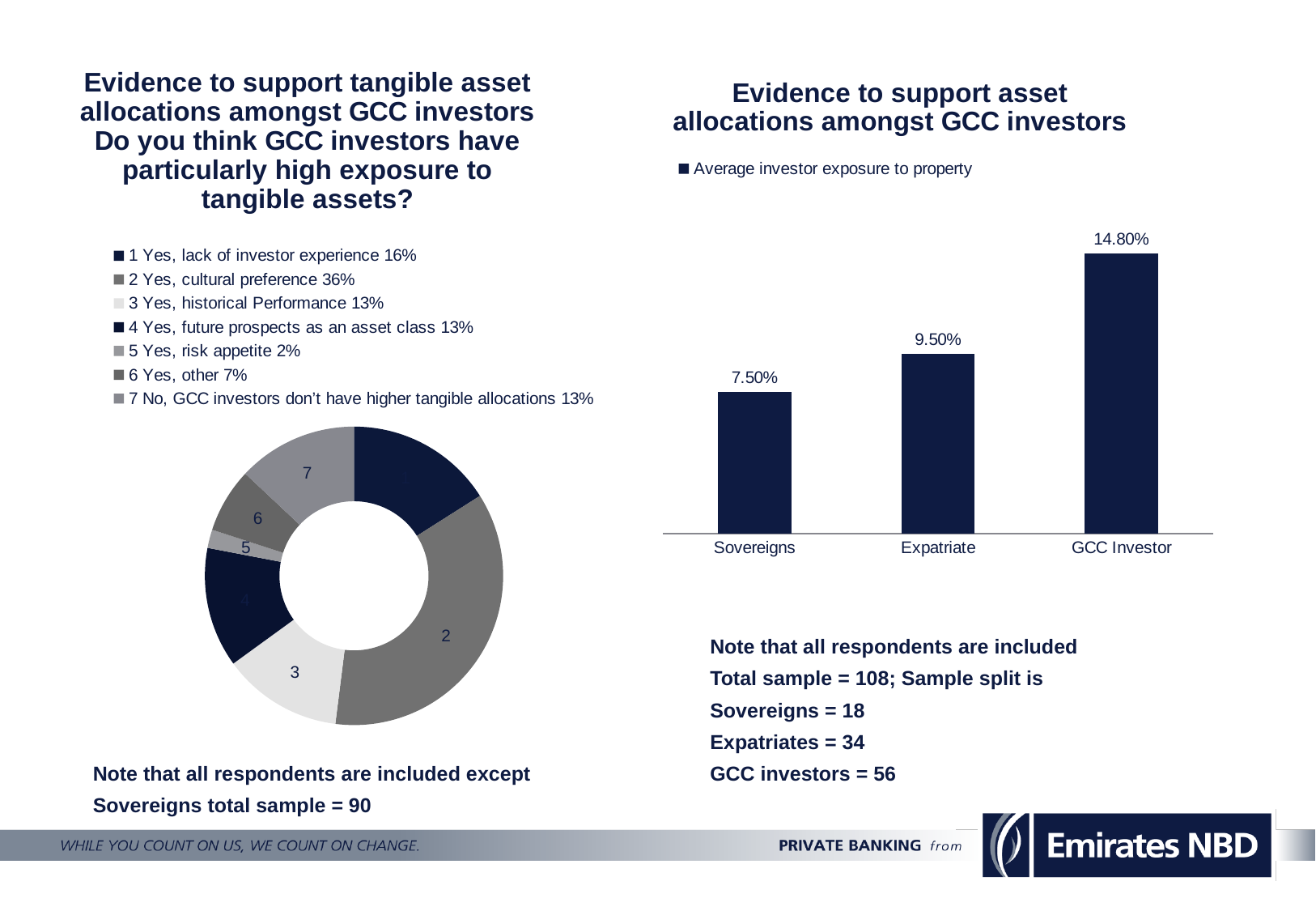
In the bar chart on the right, what is the difference between the GCC Investor value and the Expatriate value? 5.30% In the donut chart on the left, which response has the smallest share? 5 Yes, risk appetite In the bar chart on the right, which category has the lowest value? Sovereigns In the donut chart on the left, how many response categories does the legend list? 7 What kind of chart is the chart on the right? Bar chart In the bar chart on the right, what is the average investor exposure to property for GCC Investor? 14.80% In the bar chart on the right, what is the value for Sovereigns? 7.50% In the bar chart on the right, do the values rise or fall from Sovereigns to GCC Investor? Rise In the bar chart on the right, how many categories are shown? 3 In the bar chart on the right, which category has the highest average investor exposure to property? GCC Investor In the donut chart on the left, what share of respondents answered 'Yes, cultural preference'? 36% In the donut chart on the left, which response has the largest share? 2 Yes, cultural preference